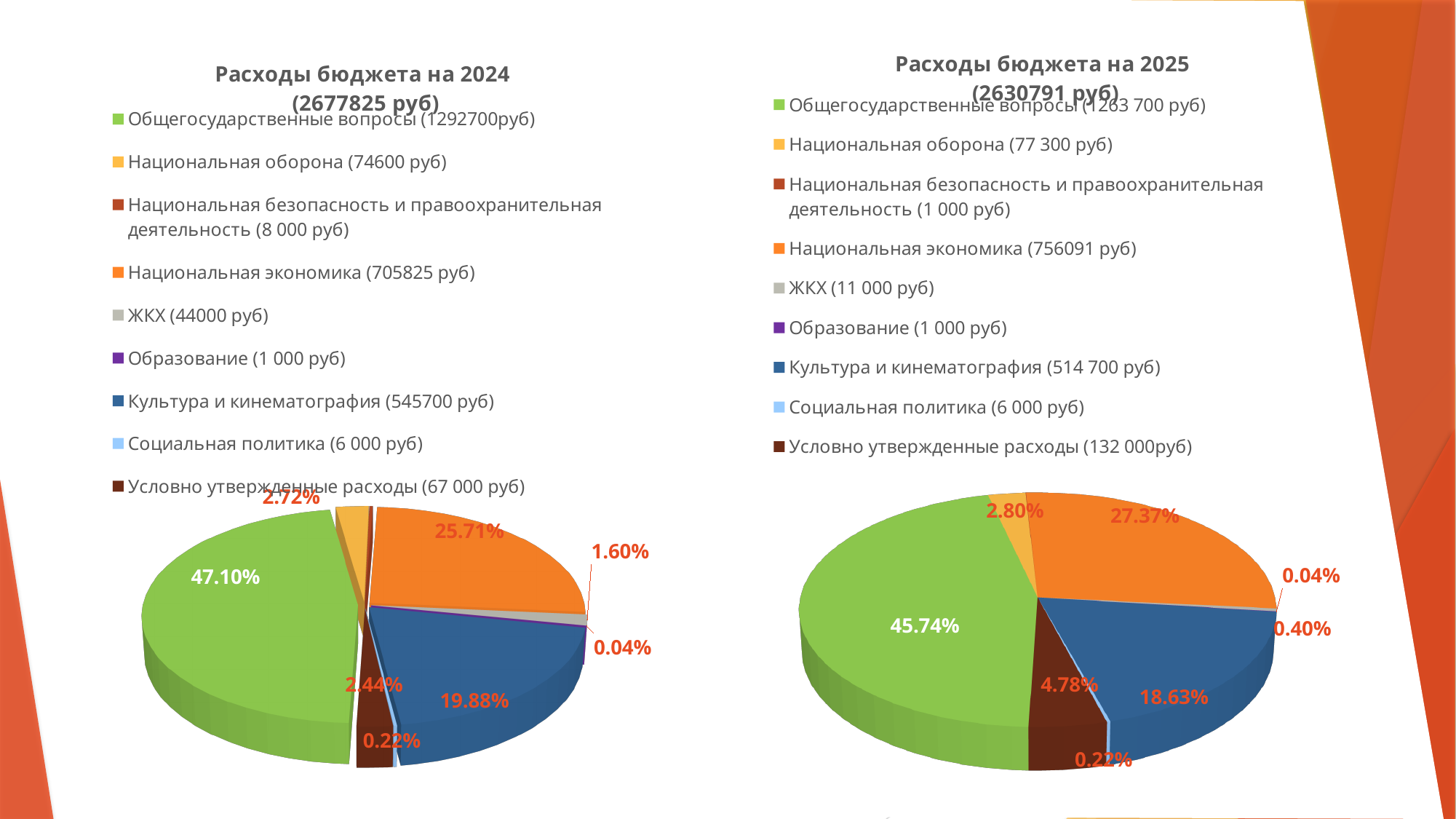
How many categories does the legend of the left chart (Расходы бюджета на 2024) list? 9 On the left chart (Расходы бюджета на 2024), which category has the largest slice? Общегосударственные вопросы On the left chart (Расходы бюджета на 2024), what share of the pie is Общегосударственные вопросы? 47.10% On the right chart (Расходы бюджета на 2025), what share of the pie is Общегосударственные вопросы? 45.74% On the right chart (Расходы бюджета на 2025), which category has the largest slice? Общегосударственные вопросы What total budget amount is shown in the title of the left chart (Расходы бюджета на 2024)? 2677825 руб On the left chart (Расходы бюджета на 2024), what is the difference in percentage points between the Общегосударственные вопросы slice and the Национальная экономика slice? 21.39 What type of chart is used on the right side of the slide (Расходы бюджета на 2025)? Pie chart On the right chart (Расходы бюджета на 2025), what share of the pie is Национальная оборона? 2.80% On the right chart (Расходы бюджета на 2025), which slice is larger: Культура и кинематография or Условно утвержденные расходы? Культура и кинематография